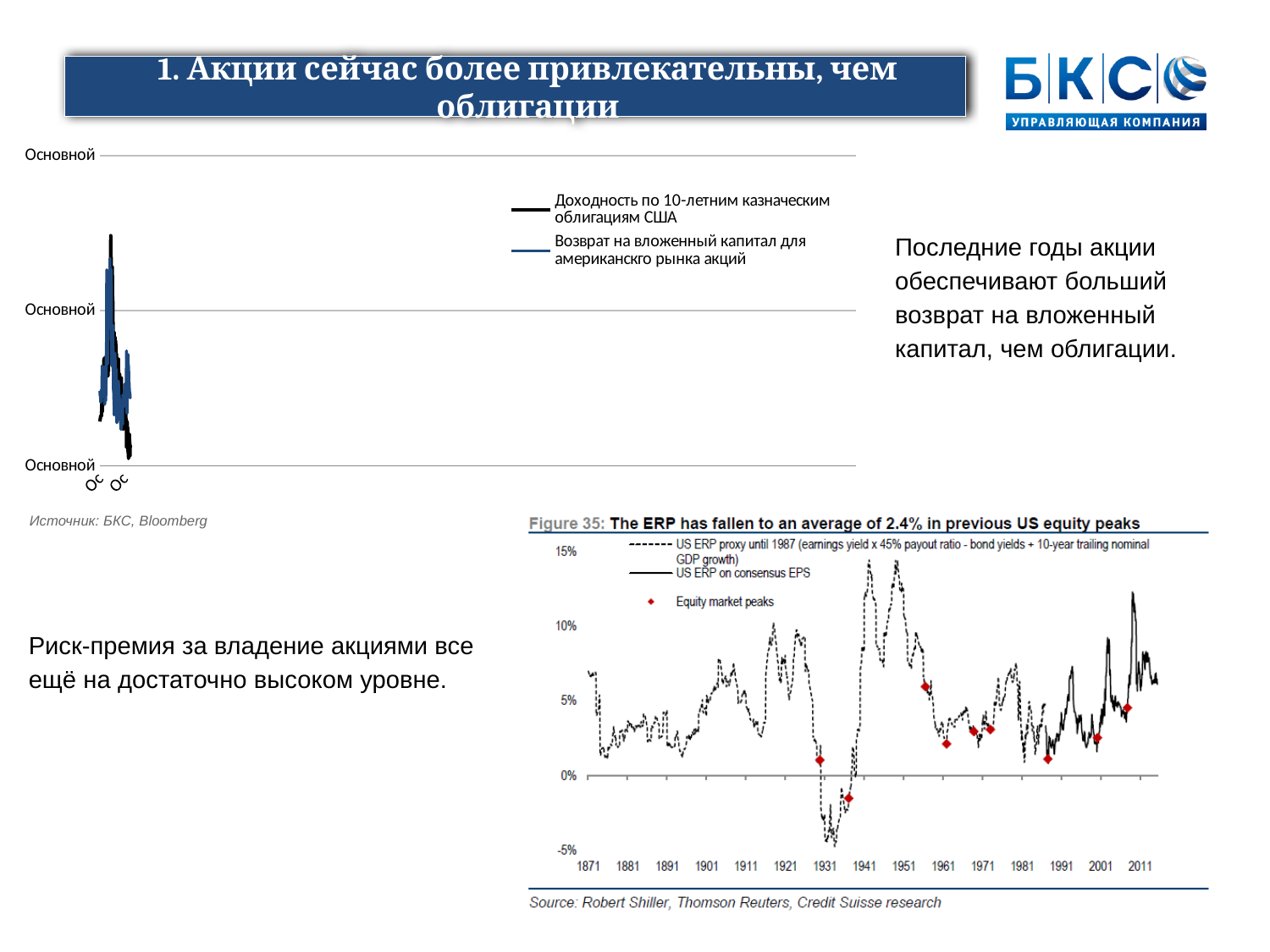
In the bottom-right chart (Figure 35), is the US ERP value around 1933 greater or less than 0%? less How many entries does the legend of the bottom-right chart (Figure 35) list? 3 What kind of chart is the top-left chart on the slide? line chart How many series does the legend of the top-left chart list? 2 What kind of chart is the bottom-right chart (Figure 35)? line chart In the bottom-right chart (Figure 35), is the US ERP value around 2009 greater or less than 10%? greater In the bottom-right chart (Figure 35), is the US ERP value around 1951 greater or less than 10%? greater What is the title of the bottom-right chart (Figure 35)? The ERP has fallen to an average of 2.4% in previous US equity peaks In the top-left chart, what is the name of the series drawn in black? Доходность по 10-летним казначеским облигациям США